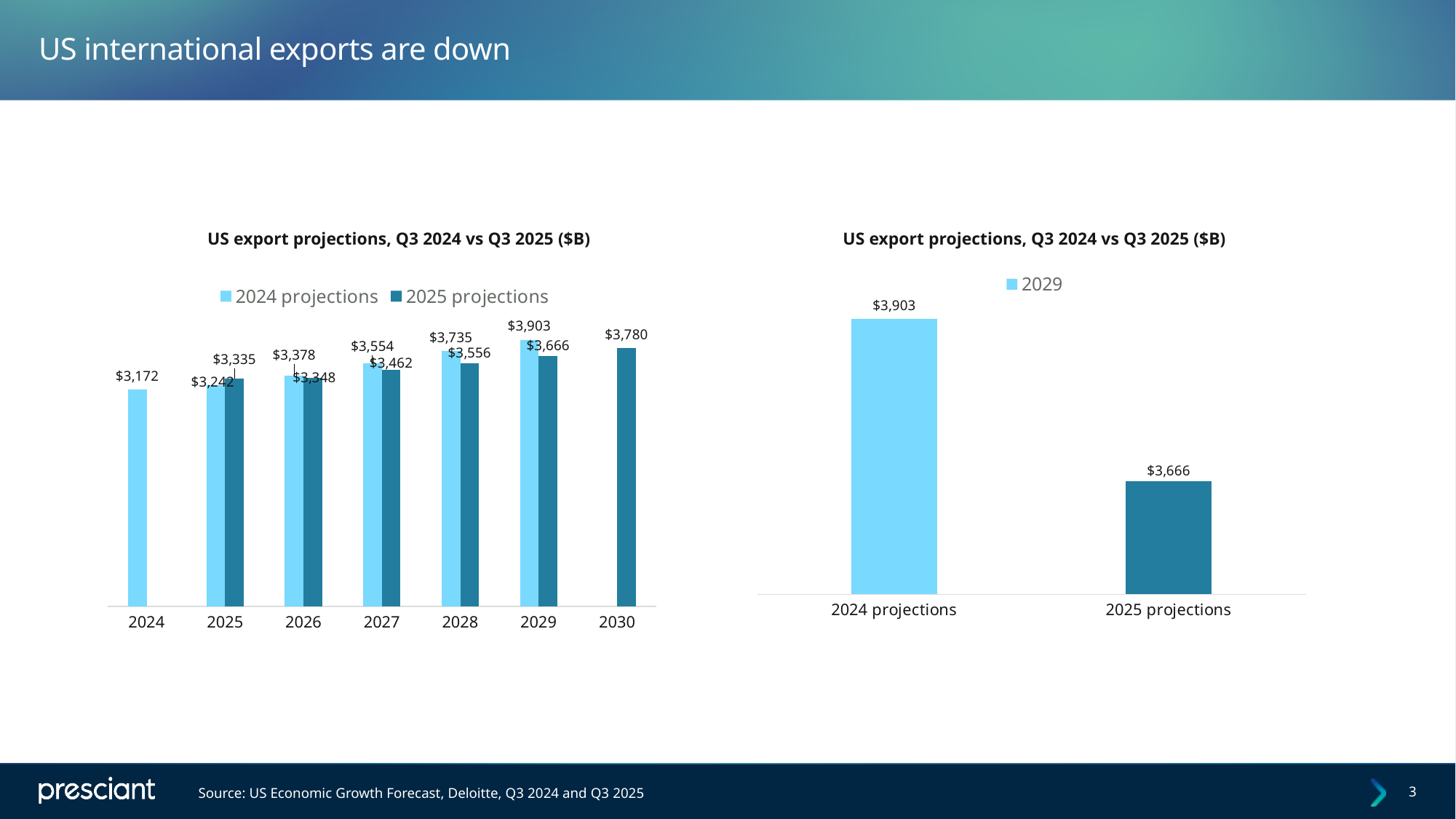
In the left chart, what is the 2024 projections value for 2028? $3,735 In the left chart, which is larger for 2026: the 2024 projections value or the 2025 projections value? 2024 projections What kind of chart is the right chart? bar chart How many series does the legend of the left chart list? 2 In the left chart, what is the 2025 projections value for 2030? $3,780 In the left chart, do the 2025 projections values rise or fall from 2025 to 2030? rise In the right chart, what is the value for 2025 projections? $3,666 In the left chart, which year has the highest 2024 projections value? 2029 In the left chart, which year has the lowest 2025 projections value? 2025 How many years are shown on the x axis of the left chart? 7 In the left chart, what is the difference between the 2024 projections and 2025 projections values for 2029? $237 In the left chart, what is the 2025 projections value for 2027? $3,462